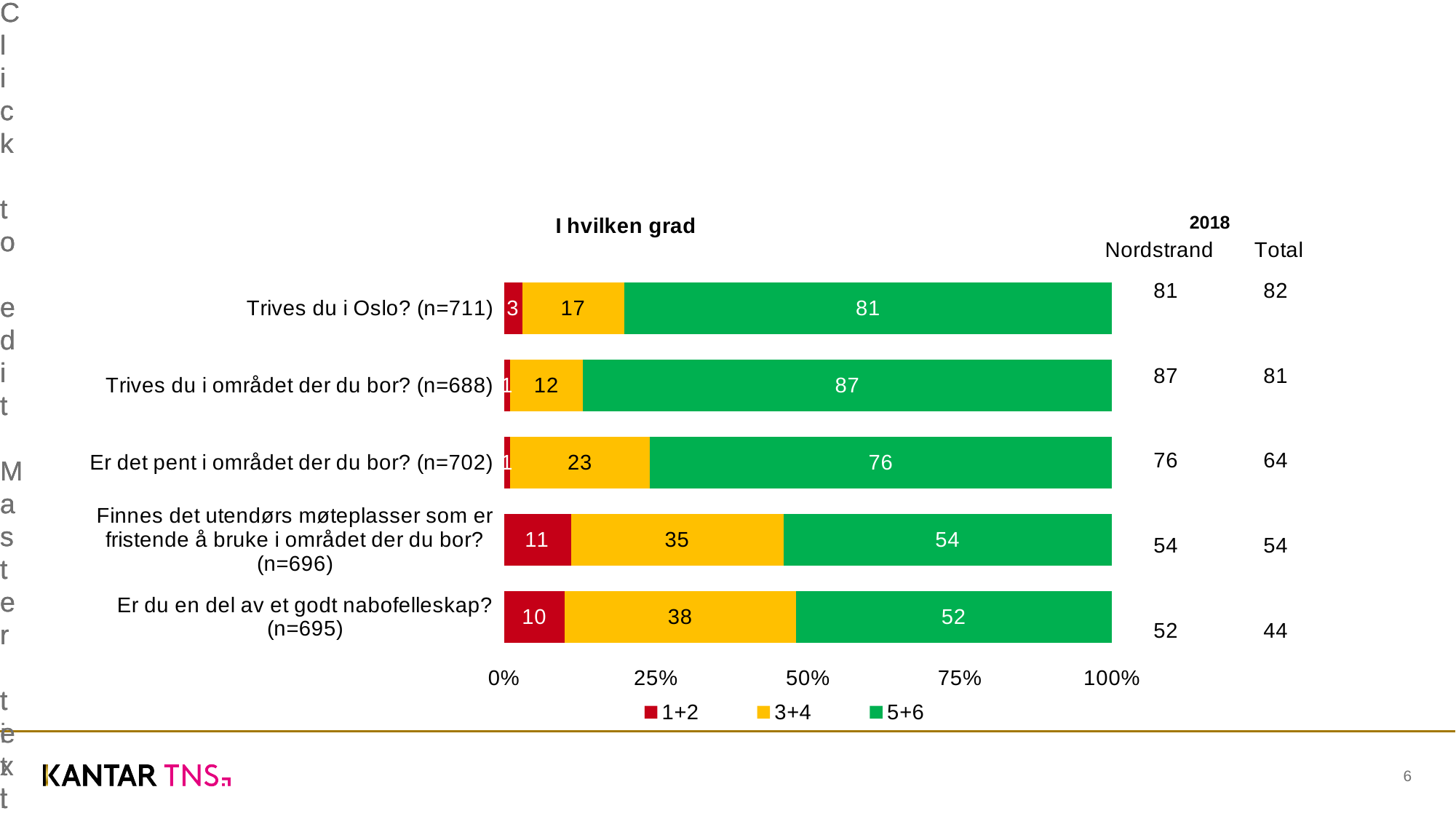
What is the difference between the 5+6 values for "Trives du i Oslo? (n=711)" and "Er det pent i området der du bor? (n=702)"? 5 What is the title of the chart? I hvilken grad What is the value of the 3+4 segment for "Er du en del av et godt nabofelleskap? (n=695)"? 38 Which question has the highest 5+6 value? Trives du i området der du bor? (n=688) What is the value of the 1+2 segment for "Finnes det utendørs møteplasser som er fristende å bruke i området der du bor? (n=696)"? 11 What kind of chart is shown on the slide? Stacked bar chart How many series does the legend list? 3 Which has the larger 3+4 value: "Finnes det utendørs møteplasser som er fristende å bruke i området der du bor? (n=696)" or "Er du en del av et godt nabofelleskap? (n=695)"? Er du en del av et godt nabofelleskap? (n=695) In the table to the right of the chart, what is the 2018 Total value for "Er det pent i området der du bor? (n=702)"? 64 How many questions (bars) are shown in the chart? 5 Which question has the lowest 5+6 value? Er du en del av et godt nabofelleskap? (n=695) What is the value of the 5+6 segment for "Trives du i området der du bor? (n=688)"? 87